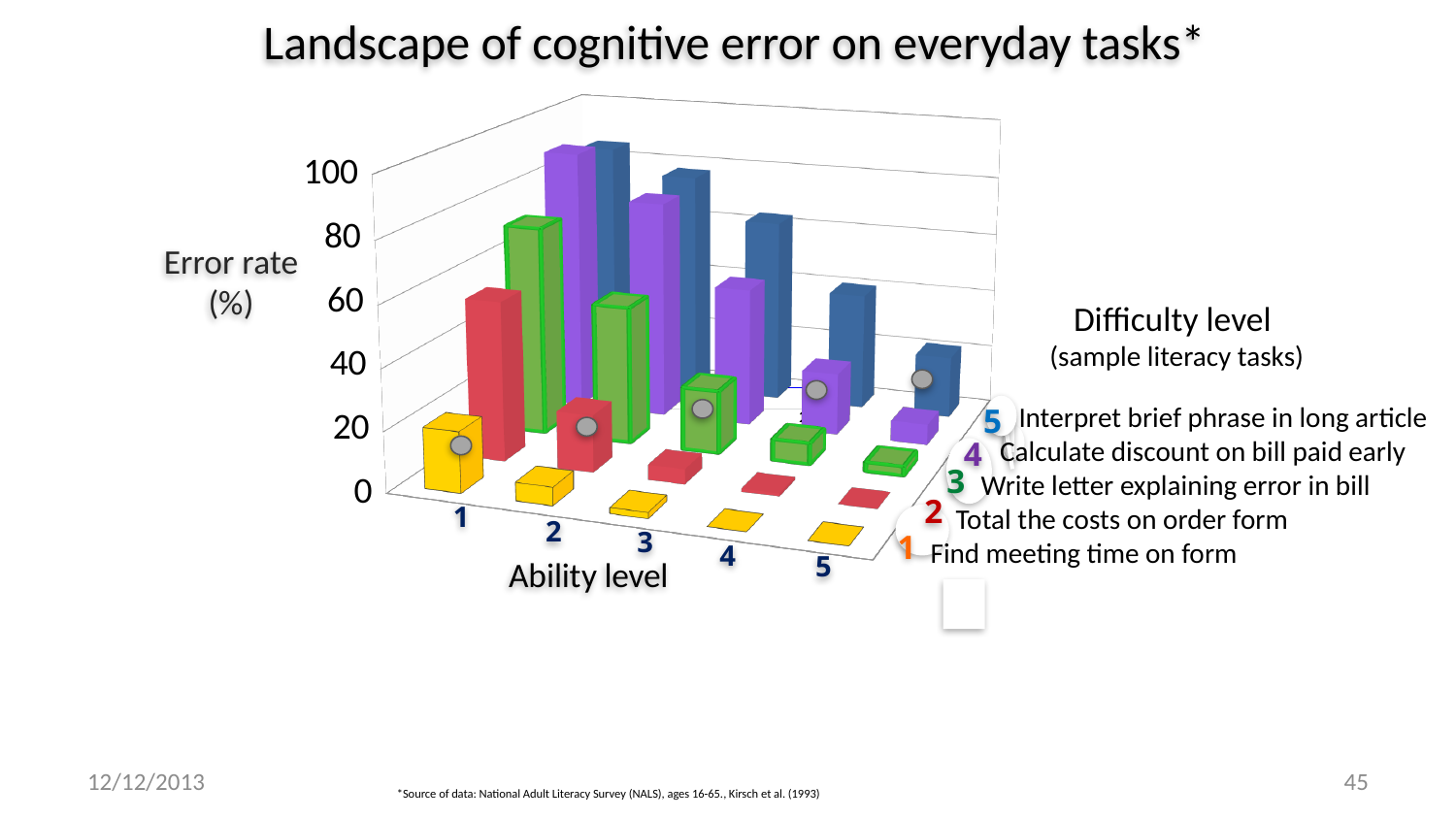
Is the error rate for difficulty level 5 at ability level 1 greater or less than 60? greater At ability level 1, which difficulty level has the lowest error rate? Difficulty level 1 For difficulty level 5, which ability level has the highest error rate? Ability level 1 How many difficulty levels (series) does the chart's legend list? 5 How many ability levels are shown along the x axis of the chart? 5 What sample literacy task does the legend give for difficulty level 3? Write letter explaining error in bill What is the label of the vertical axis of the chart? Error rate (%) At ability level 1, which has the larger error rate: difficulty level 5 or difficulty level 1? Difficulty level 5 What kind of chart is shown on the slide? bar chart Is the error rate for difficulty level 1 at ability level 5 greater or less than 20? less For difficulty level 5 (Interpret brief phrase in long article), does the error rate rise or fall as ability level increases from 1 to 5? fall